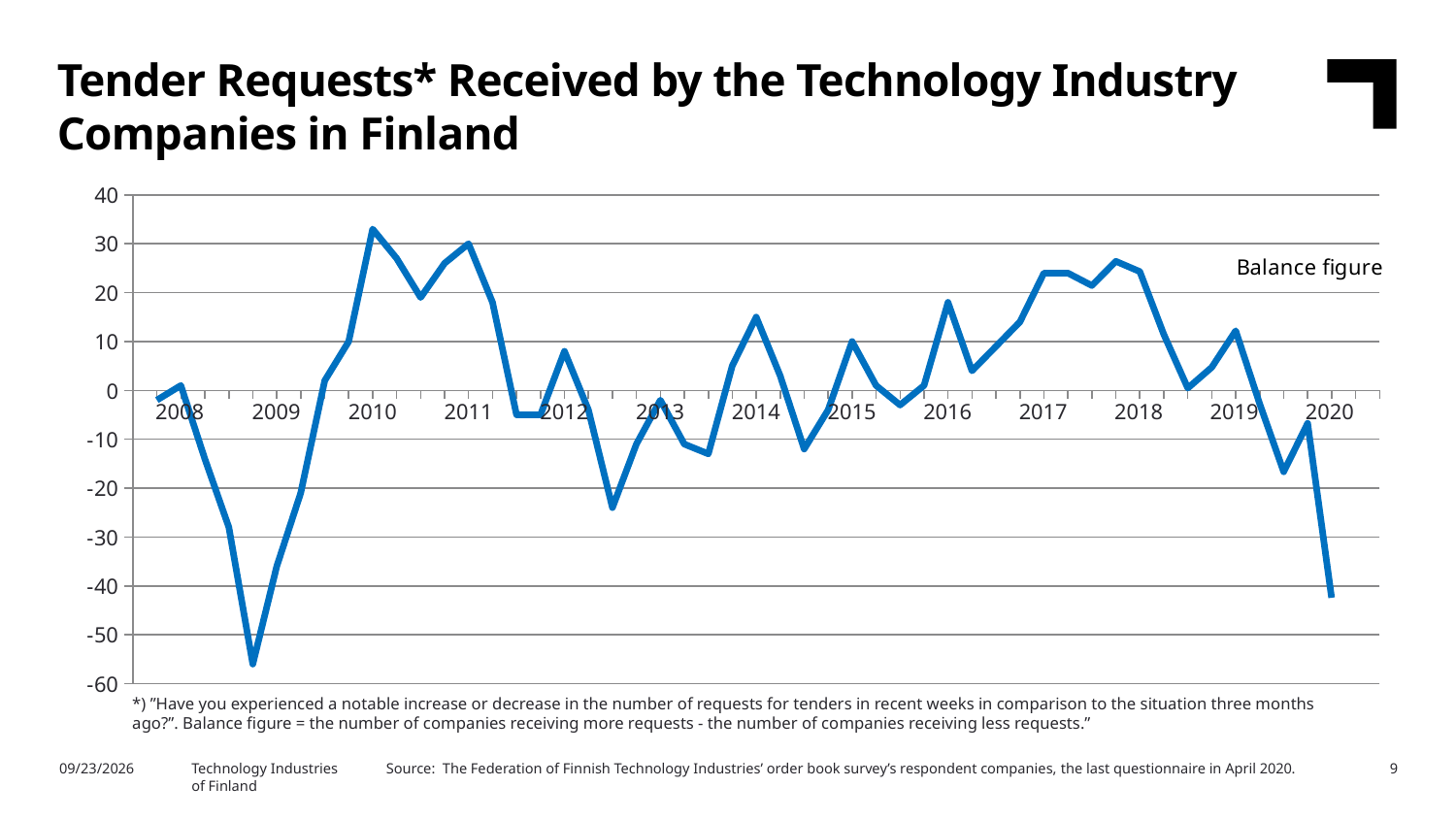
Does the line rise or fall between the end of 2019 and the end of 2020? fall Which is lower: the low point in 2009 or the low point in 2020? 2009 How many years are labelled on the x axis? 13 Is the peak value of the line in 2010 greater or less than 20? greater Is the dip in the line during 2012 greater or less than -20? less Is the lowest value of the line, in 2009, greater or less than -50? less In which year does the line reach its lowest value? 2009 Which is higher: the peak in 2010 or the peak in 2018? 2010 What kind of chart is shown on the slide? line chart What label is shown in the upper right of the plot area describing the plotted measure? Balance figure Does the line rise or fall between its low point in 2009 and its peak in 2010? rise